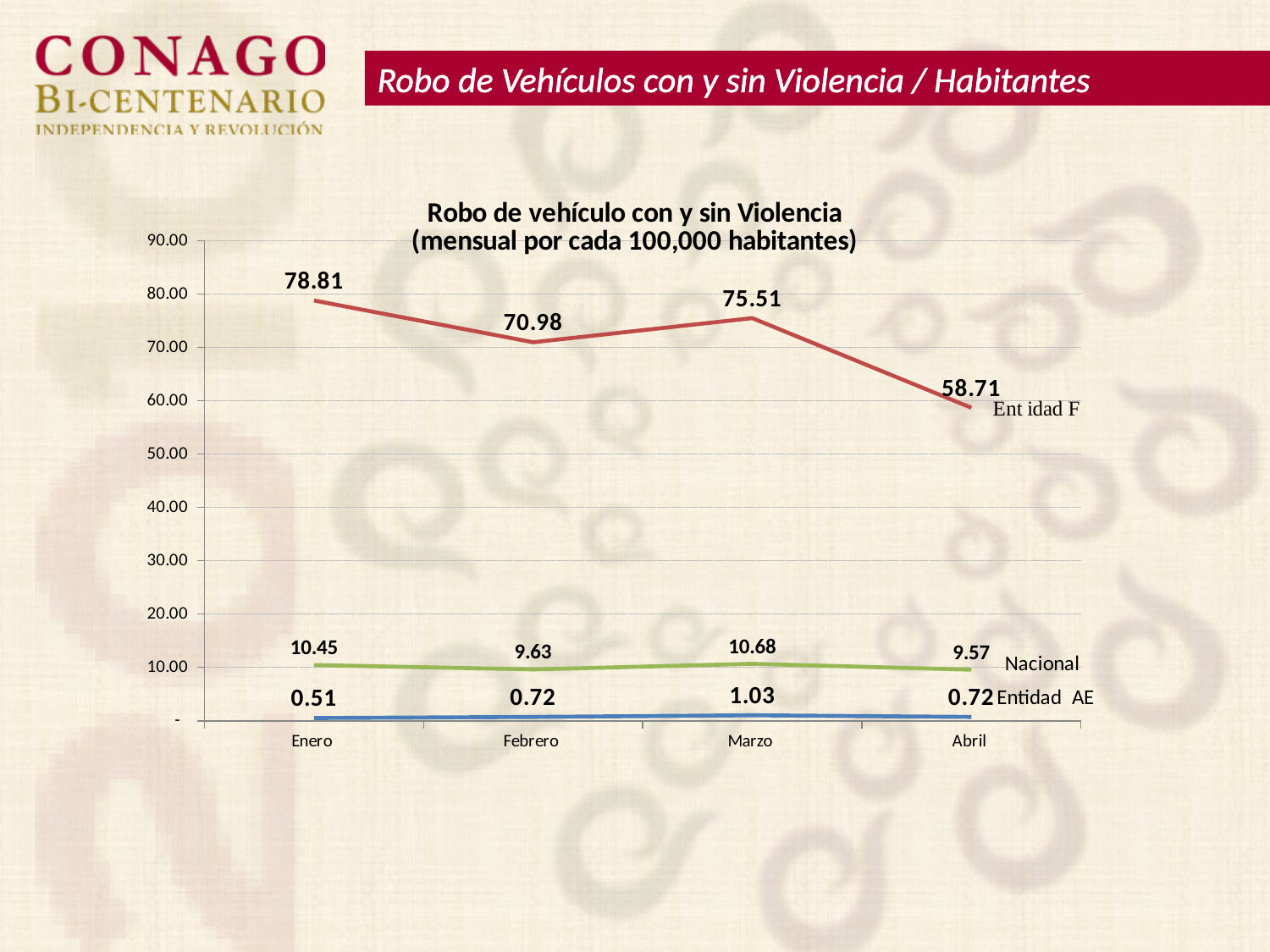
What is the value for Nacional in Marzo? 10.68 What is the value for Entidad AE in Febrero? 0.72 Which is larger, the Nacional value in Enero or in Febrero? Enero What is the value for Entidad F in Enero? 78.81 What is the title of the chart? Robo de vehículo con y sin Violencia (mensual por cada 100,000 habitantes) What kind of chart is shown on the slide? line chart How many months are shown on the x axis? 4 What is the difference between the Entidad F values for Enero and Abril? 20.10 In which month is the Nacional value highest? Marzo Does the Entidad F line rise or fall from Marzo to Abril? fall In which month is the Entidad F value lowest? Abril How many data series are plotted on the chart? 3